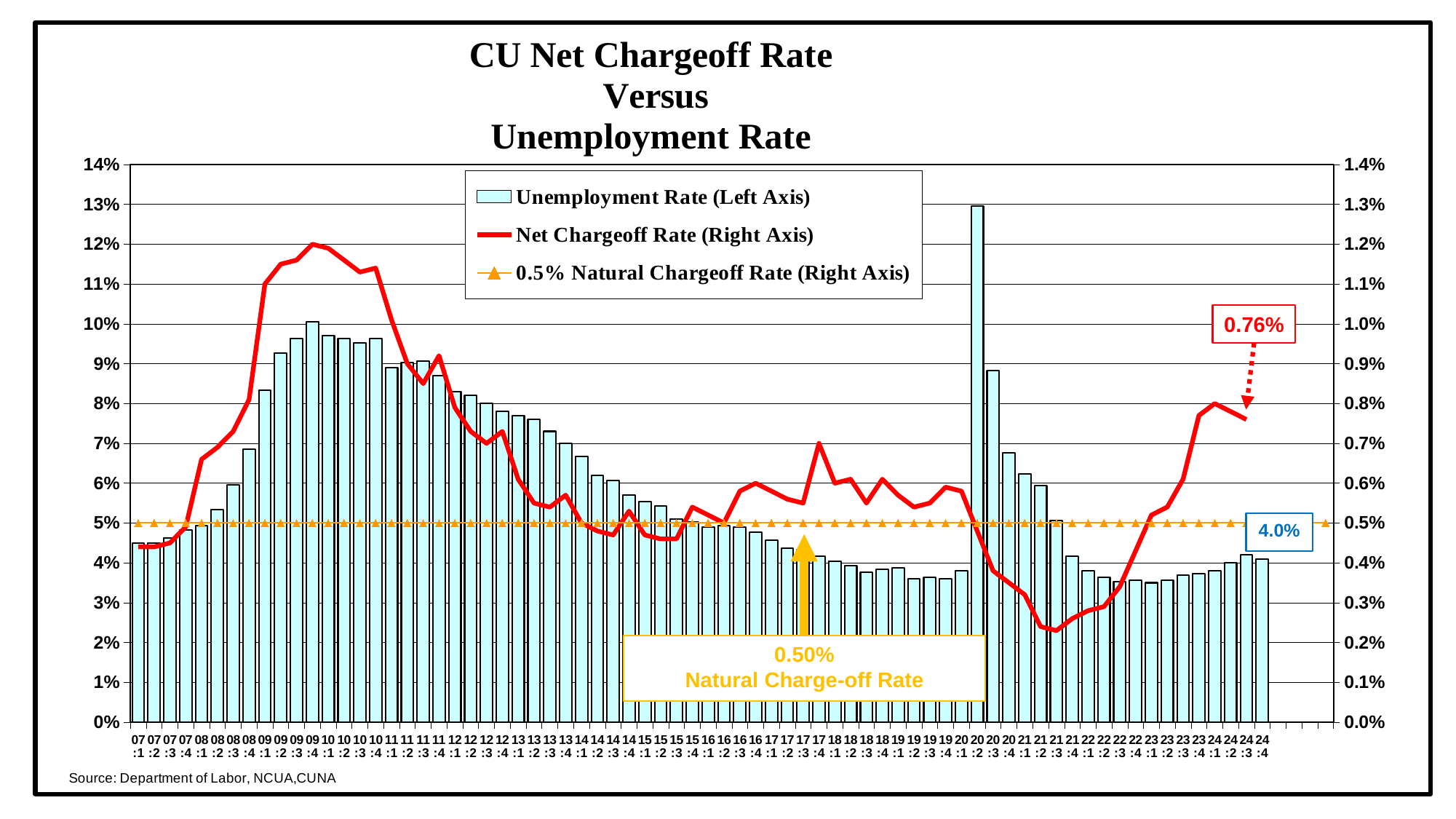
What is the Unemployment Rate labelled for the final quarter, 24:4? 4.0% What value is the Natural Charge-off Rate line set at? 0.50% What is the title of the chart? CU Net Chargeoff Rate Versus Unemployment Rate Is the Net Chargeoff Rate for 09:4 greater or less than 1.0%? greater Does the Net Chargeoff Rate rise or fall between 21:3 and 24:1? Rise Which is larger, the Net Chargeoff Rate in 09:4 or in 24:4? 09:4 In which quarter is the Unemployment Rate bar highest? 20:2 What is the Net Chargeoff Rate labelled for the final quarter, 24:4? 0.76% How many series does the legend list? 3 Is the Unemployment Rate for 20:2 greater or less than 12%? greater Is the Net Chargeoff Rate for 21:2 greater or less than 0.3%? less What kind of chart is used to show the Unemployment Rate series? Bar chart